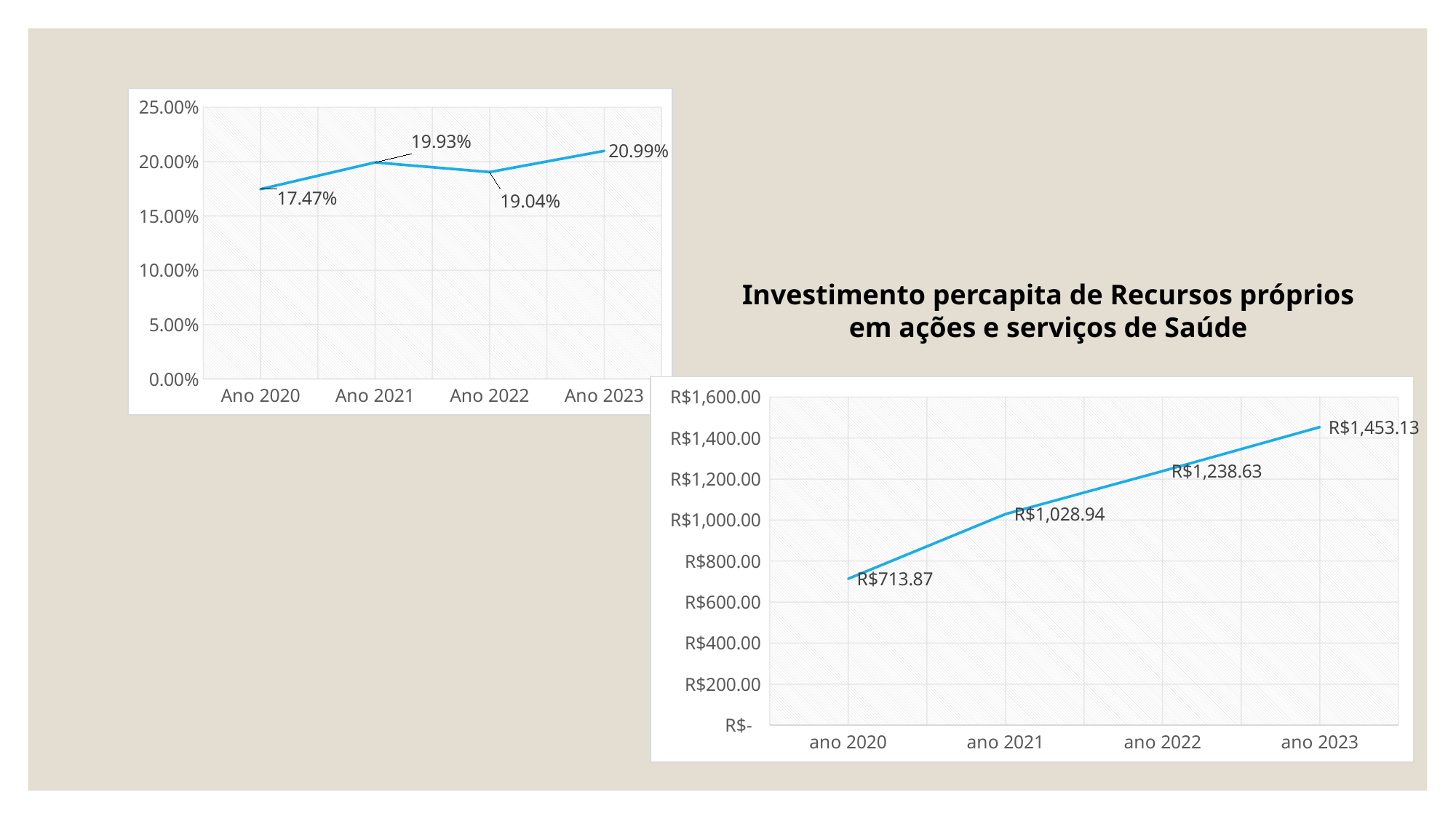
In the chart titled 'Investimento percapita de Recursos próprios em ações e serviços de Saúde', what is the value for ano 2021? R$1,028.94 In the top-left chart, what is the difference between the values for Ano 2023 and Ano 2020? 3.52% In the top-left chart, what is the value for Ano 2022? 19.04% In the top-left chart, which year has the highest value? Ano 2023 In the chart titled 'Investimento percapita de Recursos próprios em ações e serviços de Saúde', what is the value for ano 2023? R$1,453.13 How many data points are plotted in the chart titled 'Investimento percapita de Recursos próprios em ações e serviços de Saúde'? 4 In the chart titled 'Investimento percapita de Recursos próprios em ações e serviços de Saúde', do the values rise or fall from ano 2020 to ano 2023? rise What kind of chart is the top-left chart? line chart In the top-left chart, which year has the lowest value? Ano 2020 In the top-left chart, which is larger: the value for Ano 2021 or Ano 2022? Ano 2021 In the top-left chart, what is the value for Ano 2020? 17.47% In the chart titled 'Investimento percapita de Recursos próprios em ações e serviços de Saúde', what is the difference between the values for ano 2023 and ano 2020? R$739.26